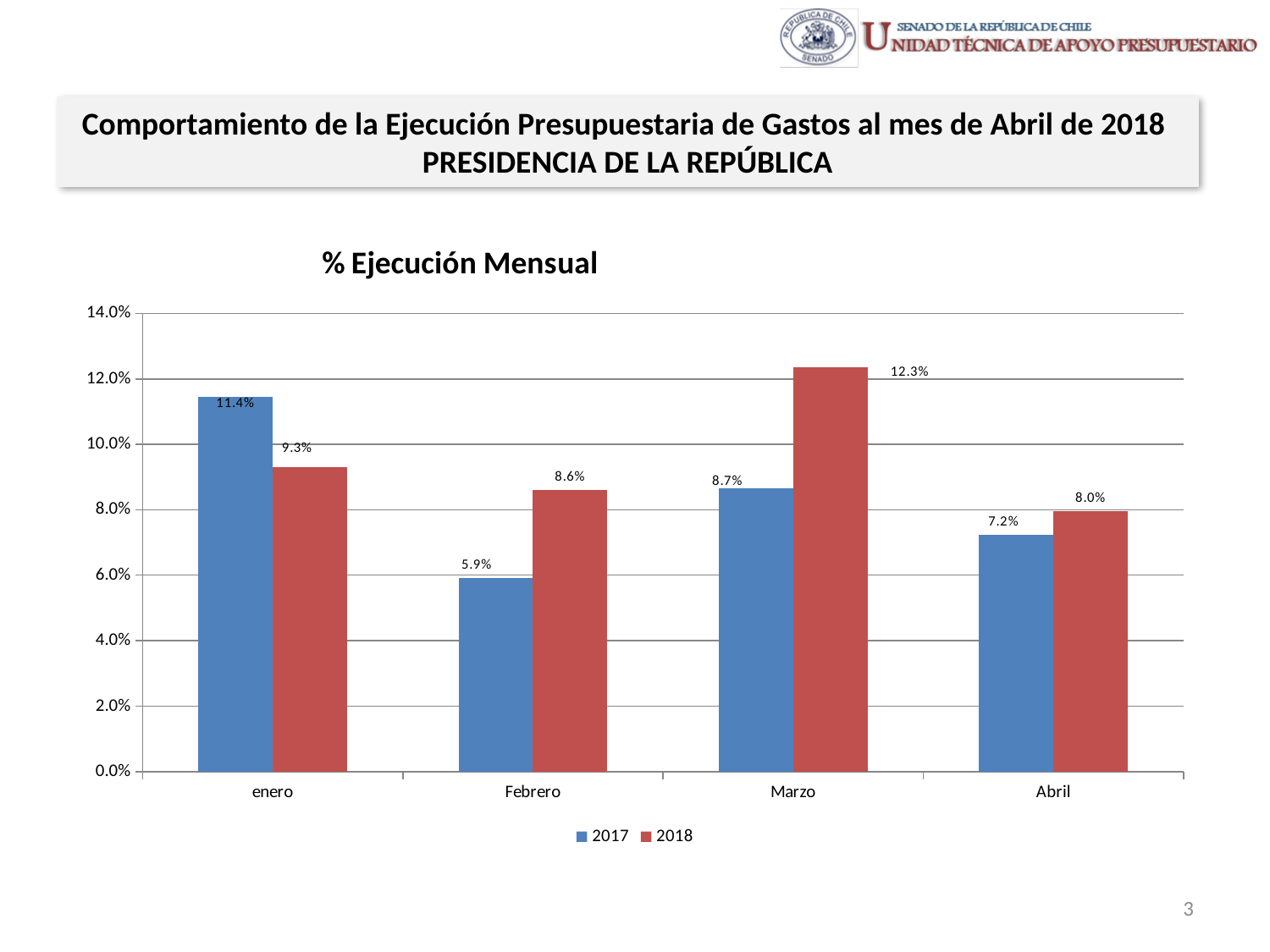
How many months are shown on the x axis? 4 What is the title of the chart? % Ejecución Mensual What kind of chart is shown? Bar chart What is the value for 2018 in Marzo? 12.3% What is the value for 2017 in Abril? 7.2% Which is larger in enero, the 2017 value or the 2018 value? 2017 How many series does the legend list? 2 Which month has the lowest value for the 2017 series? Febrero Which month has the highest value for the 2018 series? Marzo What is the value for 2017 in enero? 11.4% What is the value for 2018 in Febrero? 8.6% What is the difference between the 2018 and 2017 values in Marzo? 3.6%